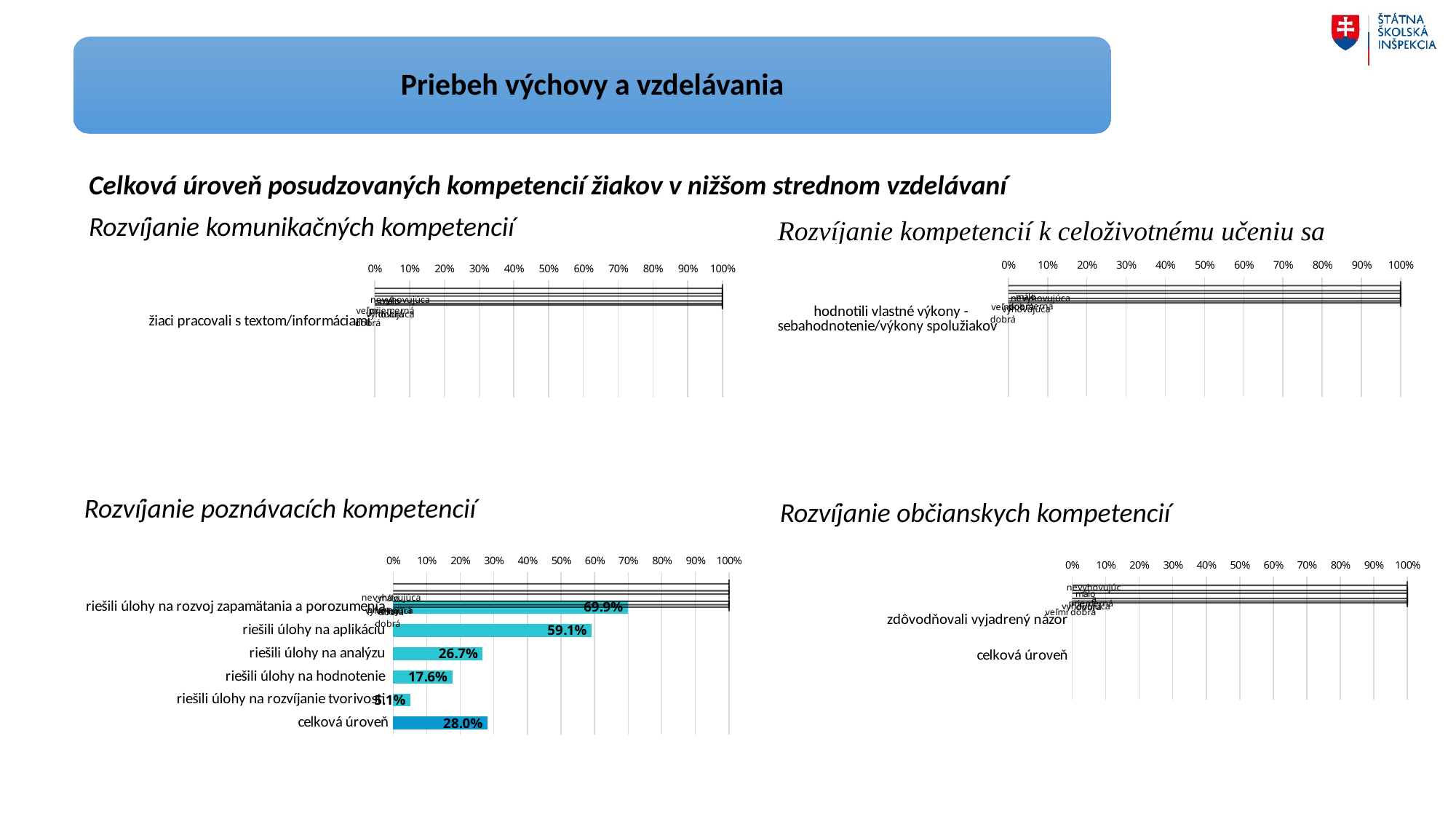
In the chart 'Rozvíjanie poznávacích kompetencií', which category has the highest value? riešili úlohy na rozvoj zapamätania a porozumenia In the chart 'Rozvíjanie poznávacích kompetencií', how many categories have labelled bars? 6 In the chart 'Rozvíjanie poznávacích kompetencií', what is the value for 'riešili úlohy na analýzu'? 26.7% In the chart 'Rozvíjanie poznávacích kompetencií', which category has the lowest value? riešili úlohy na rozvíjanie tvorivosti In the chart 'Rozvíjanie poznávacích kompetencií', what is the difference between the values for 'riešili úlohy na rozvoj zapamätania a porozumenia' and 'riešili úlohy na aplikáciu'? 10.8% In the chart 'Rozvíjanie poznávacích kompetencií', which is larger: the value for 'riešili úlohy na analýzu' or for 'celková úroveň'? celková úroveň In the chart 'Rozvíjanie poznávacích kompetencií', what is the value for 'celková úroveň'? 28.0% In the chart 'Rozvíjanie poznávacích kompetencií', is the value for 'riešili úlohy na aplikáciu' greater or less than 50%? greater How many charts are shown on the slide? 4 What kind of chart is 'Rozvíjanie poznávacích kompetencií'? bar chart In the chart 'Rozvíjanie poznávacích kompetencií', what is the value for 'riešili úlohy na aplikáciu'? 59.1% In the chart 'Rozvíjanie poznávacích kompetencií', what is the value for 'riešili úlohy na hodnotenie'? 17.6%